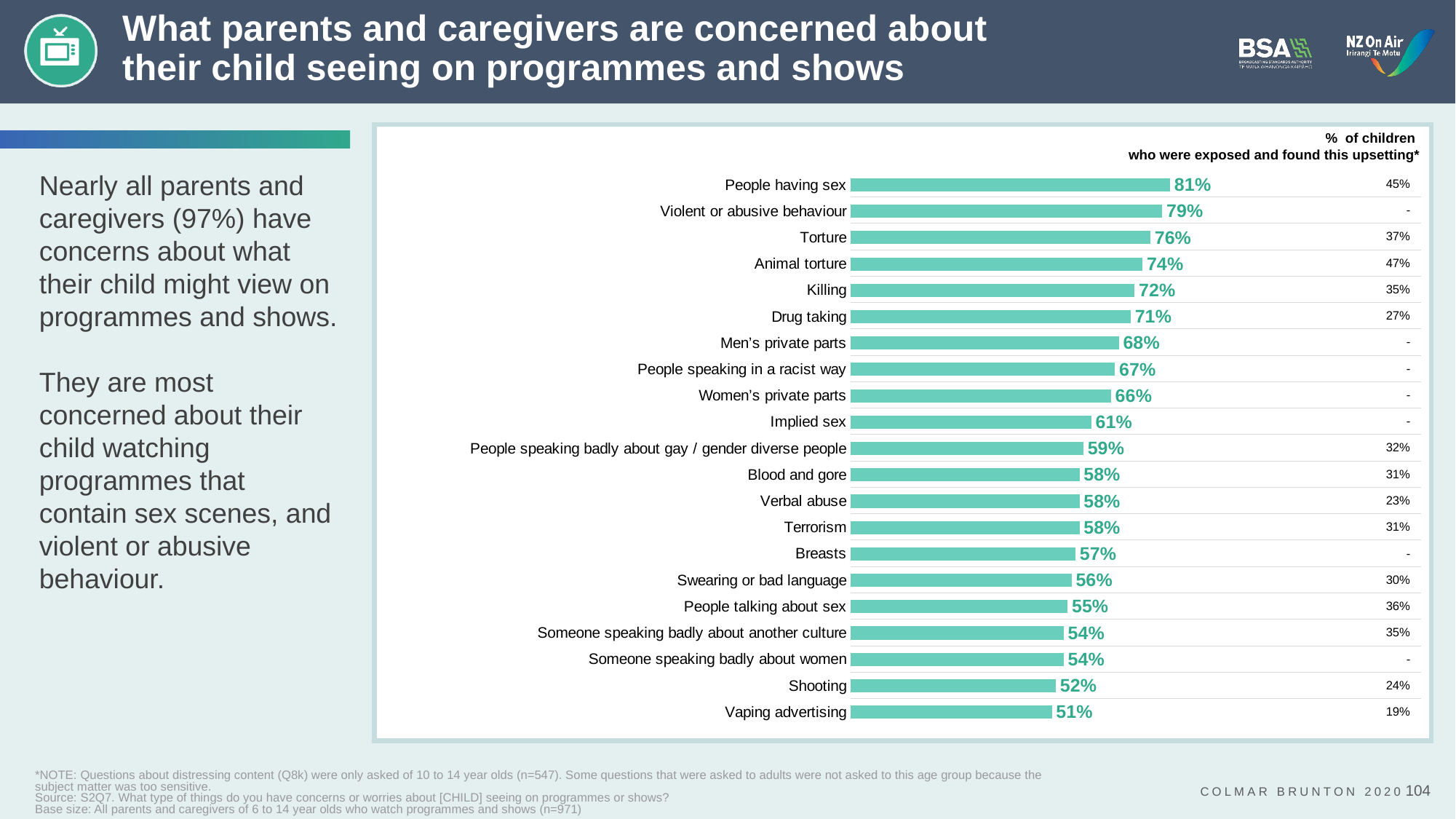
What percentage of parents and caregivers are concerned about their child seeing people having sex? 81% Which has a higher percentage of concerned parents: killing or terrorism? Killing How many concern categories are shown in the chart? 21 What is the difference in percentage points between concern about torture and concern about shooting? 24 What type of chart is used on this slide? Bar chart What percentage of parents and caregivers are concerned about their child seeing drug taking? 71% What colour are the bars in the chart? Teal/green Which concern has the highest percentage in the chart? People having sex Which concern has the lowest percentage in the chart? Vaping advertising According to the right-hand column, what percentage of children who were exposed to animal torture found it upsetting? 47% What is the difference in percentage points between concern about violent or abusive behaviour and concern about implied sex? 18 What percentage of parents and caregivers are concerned about their child seeing vaping advertising? 51%